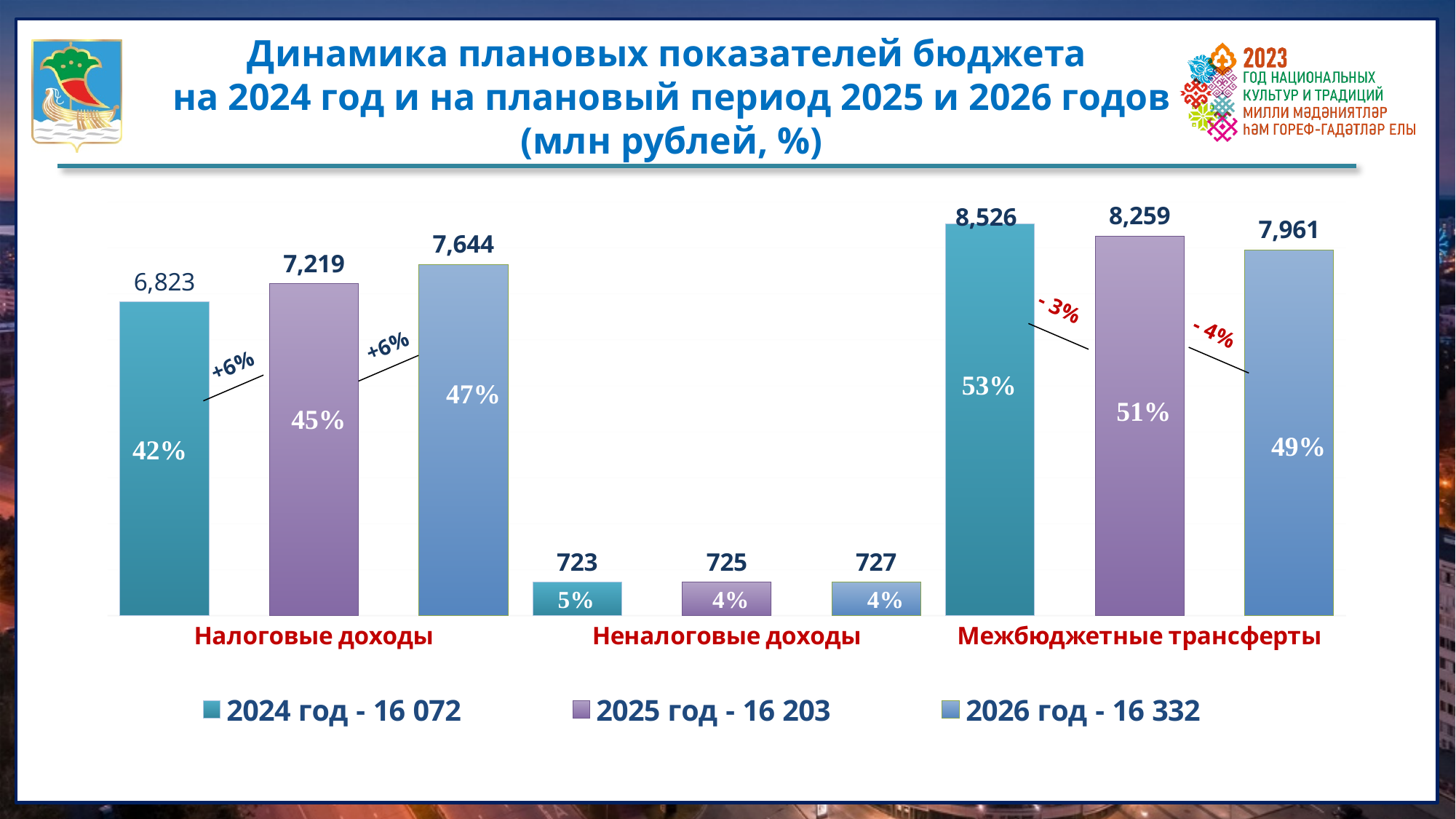
How many categories are shown on the x axis? 3 Which category has the highest value in the 2024 год series? Межбюджетные трансферты What is the value for Неналоговые доходы in the 2025 год series? 725 What is the difference between the 2024 год and 2025 год values for Межбюджетные трансферты? 267 What is the value for Налоговые доходы in the 2024 год series? 6,823 What is the difference between the 2026 год and 2024 год values for Налоговые доходы? 821 What percentage share is shown inside the 2024 год bar for Межбюджетные трансферты? 53% How many series does the legend list? 3 What is the value for Межбюджетные трансферты in the 2026 год series? 7,961 Which category has the lowest values across all three series? Неналоговые доходы What kind of chart is shown on the slide? Bar chart Which is larger: the 2026 год value for Налоговые доходы or the 2026 год value for Межбюджетные трансферты? Межбюджетные трансферты